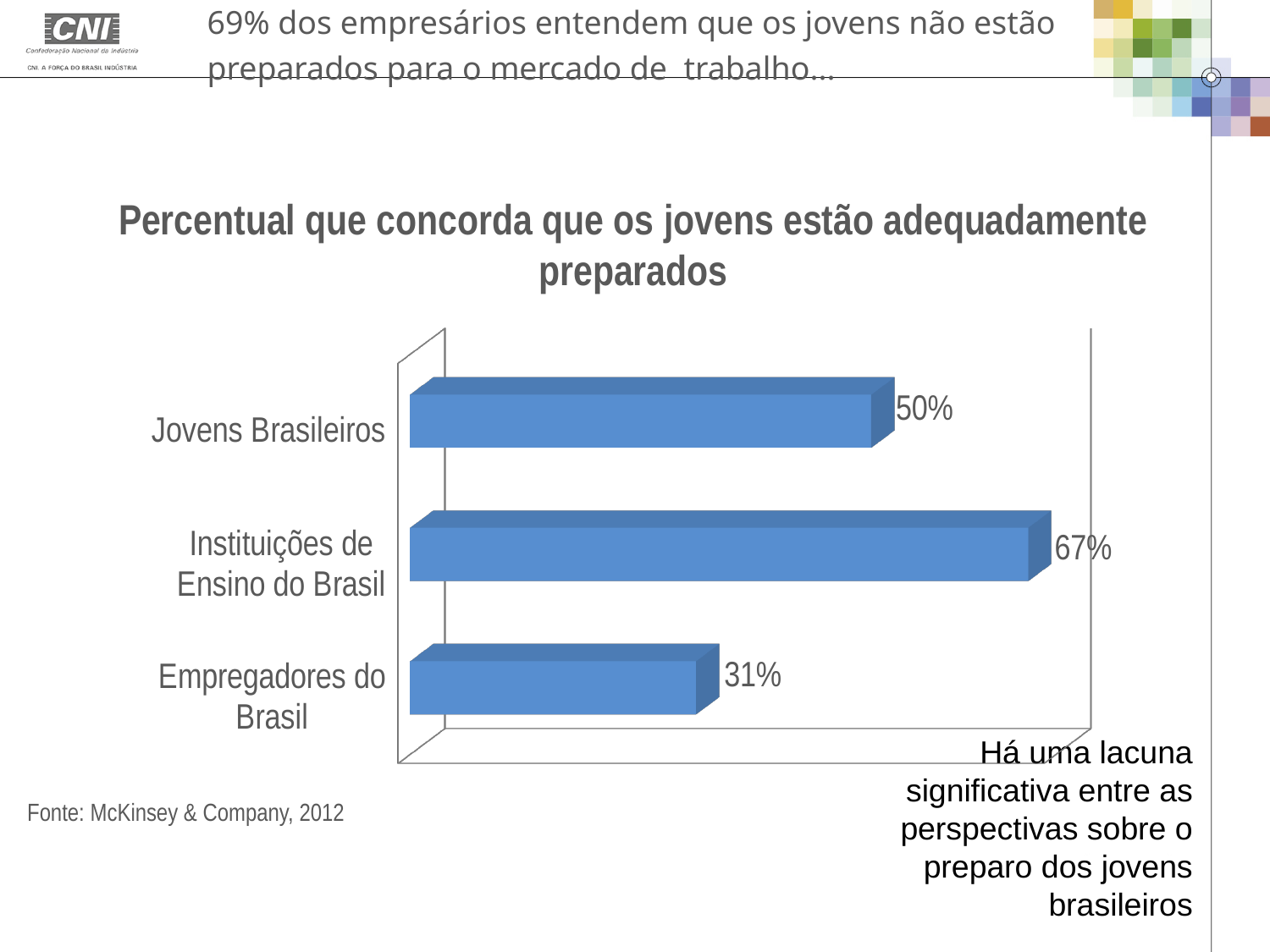
What kind of chart is shown on the slide? Bar chart What source is cited for the chart? McKinsey & Company, 2012 How many categories are shown in the chart? 3 What is the difference between the values for Instituições de Ensino do Brasil and Empregadores do Brasil? 36% What is the title of the chart? Percentual que concorda que os jovens estão adequadamente preparados Which category has the lowest value? Empregadores do Brasil Which is larger, the value for Jovens Brasileiros or the value for Instituições de Ensino do Brasil? Instituições de Ensino do Brasil What is the difference between the values for Jovens Brasileiros and Empregadores do Brasil? 19% Which category has the highest value? Instituições de Ensino do Brasil What is the value for Jovens Brasileiros? 50% What is the value for Instituições de Ensino do Brasil? 67% What is the value for Empregadores do Brasil? 31%